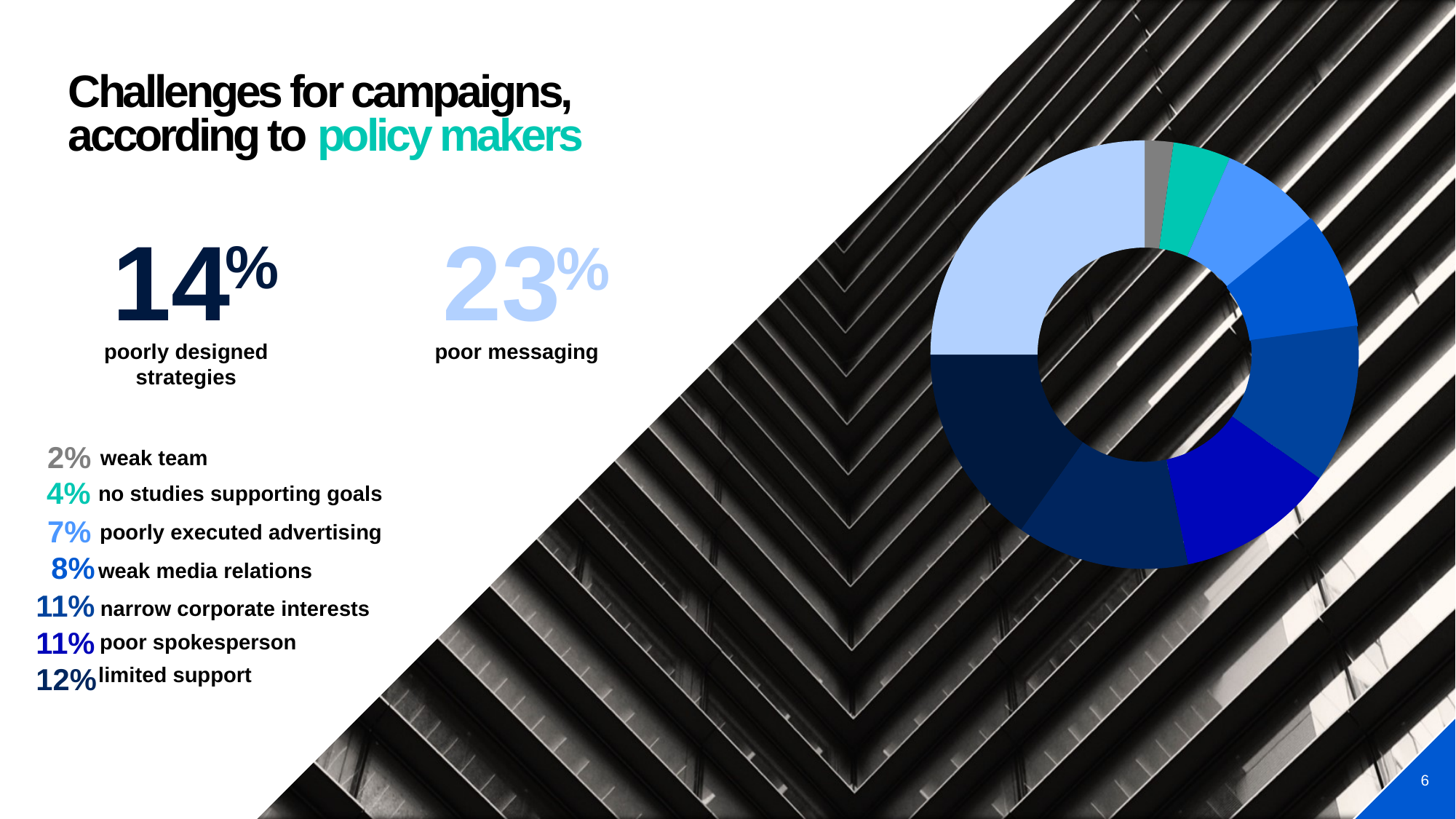
What percentage is shown for weak media relations? 8% How many challenge categories are listed for the chart? 9 What percentage is shown for limited support? 12% Which challenge has the smallest share in the chart? weak team Which two challenges share the same value of 11%? narrow corporate interests and poor spokesperson What percentage of policy makers cited poor messaging as a challenge? 23% Which challenge has the largest share in the chart? poor messaging What kind of chart is shown on the slide? Donut (pie) chart What percentage is shown for poorly designed strategies? 14% Which is larger: the share for poorly executed advertising or the share for weak media relations? weak media relations What is the difference between the shares for limited support and no studies supporting goals? 8 percentage points What is the difference between the shares for poor messaging and poorly designed strategies? 9 percentage points